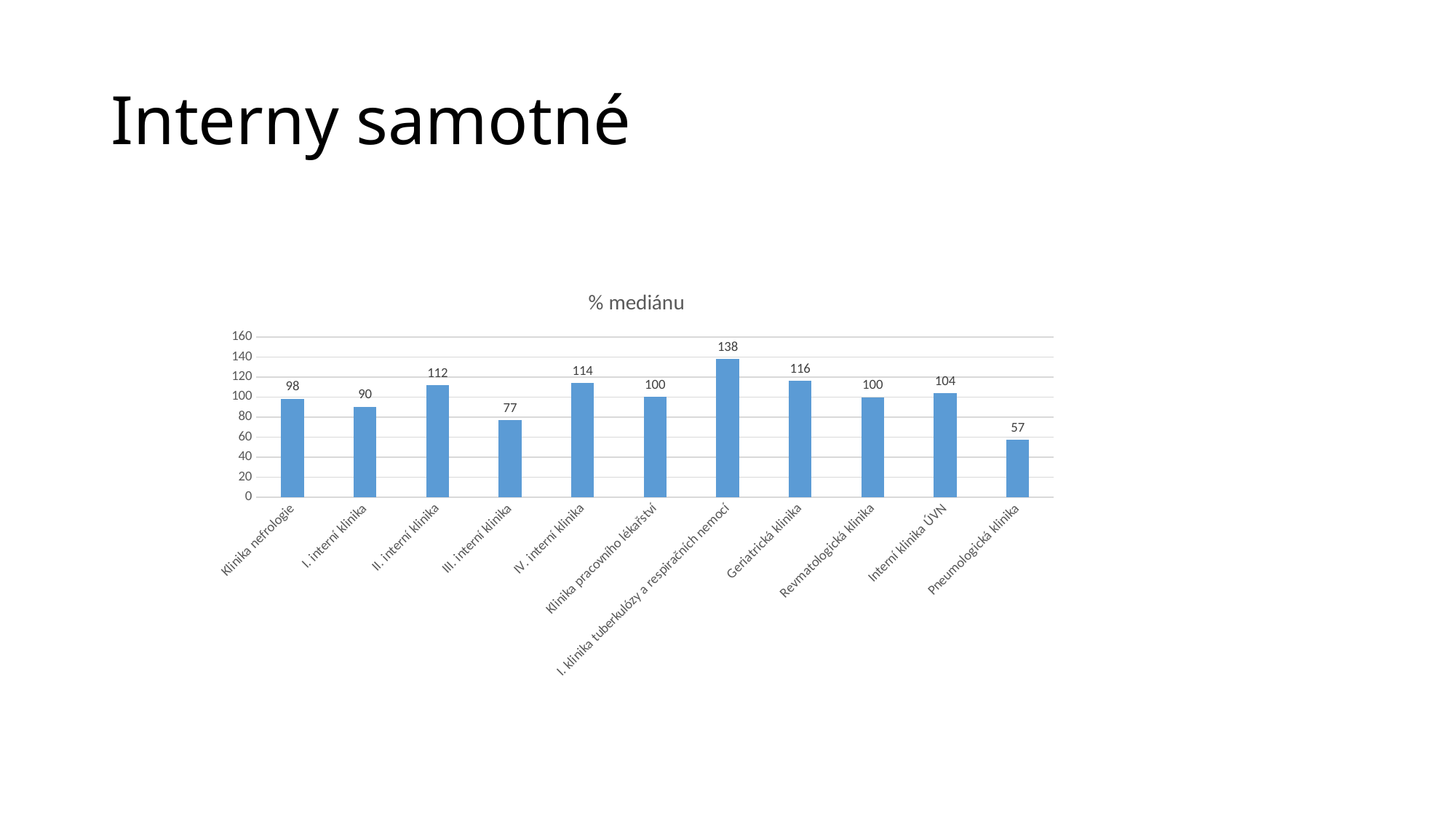
What is the title of the chart? % mediánu What is the value for Geriatrická klinika? 116 Which is larger, the value for II. interní klinika or the value for Interní klinika ÚVN? II. interní klinika What is the value for Klinika nefrologie? 98 What is the value for Pneumologická klinika? 57 Which category has the highest value? I. klinika tuberkulózy a respiračních nemocí What is the value for III. interní klinika? 77 What is the difference between the values for IV. interní klinika and I. interní klinika? 24 Is the value for I. klinika tuberkulózy a respiračních nemocí greater or less than 120? greater How many categories are shown in the chart? 11 Which category has the lowest value? Pneumologická klinika What kind of chart is shown on the slide? bar chart